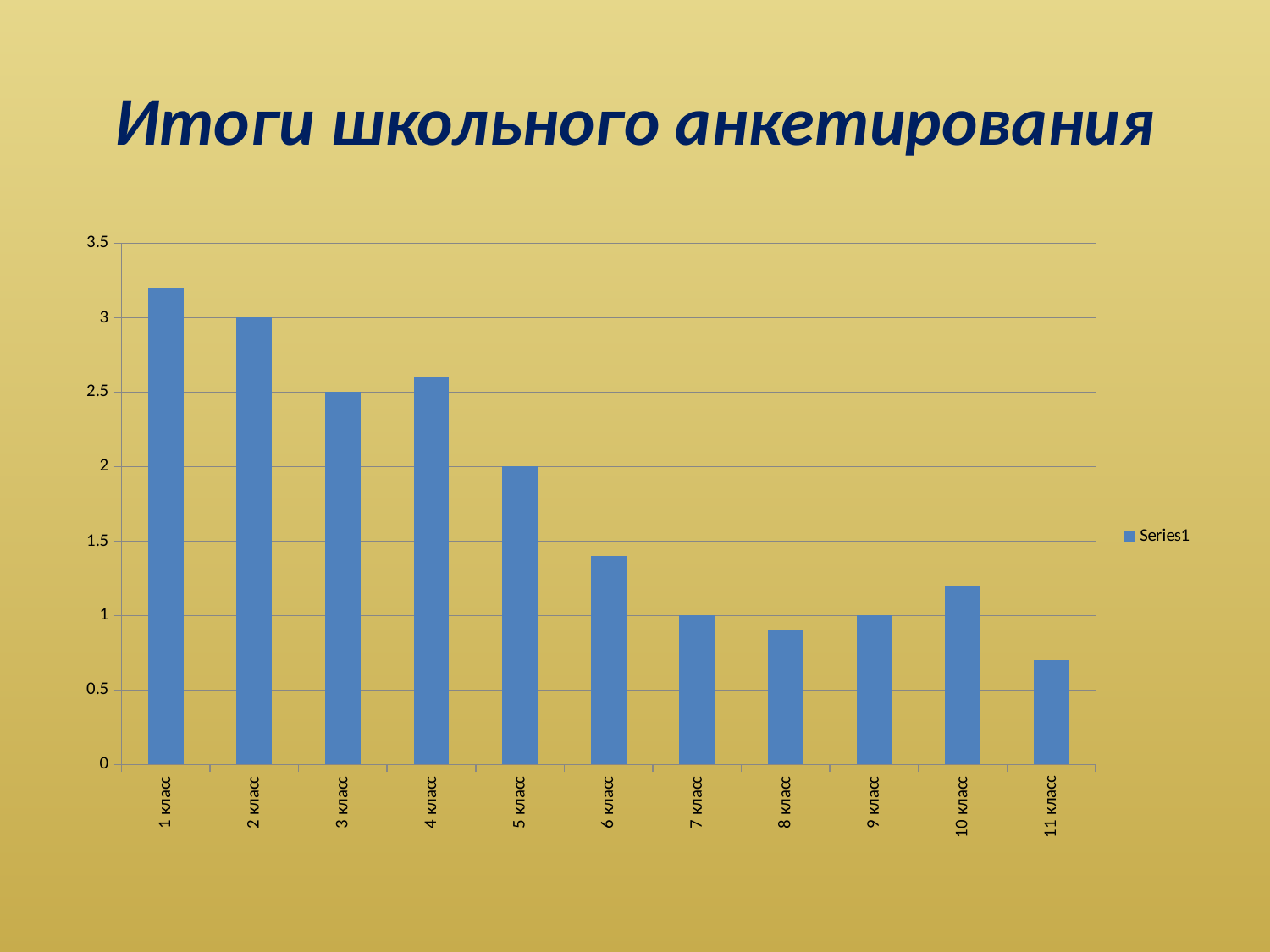
Which class has the lowest value? 11 класс What is the value for 3 класс? 2.5 Is the value for 1 класс greater or less than 3? greater How many classes (categories) are shown on the x axis? 11 What is the value for 5 класс? 2 What is the value for 2 класс? 3 What is the difference between the values for 2 класс and 5 класс? 1 Do the values generally rise or fall from 1 класс to 11 класс? fall How many series does the legend list? 1 Which class has the highest value? 1 класс Is the value for 8 класс greater or less than 1? less What kind of chart is shown on the slide? bar chart